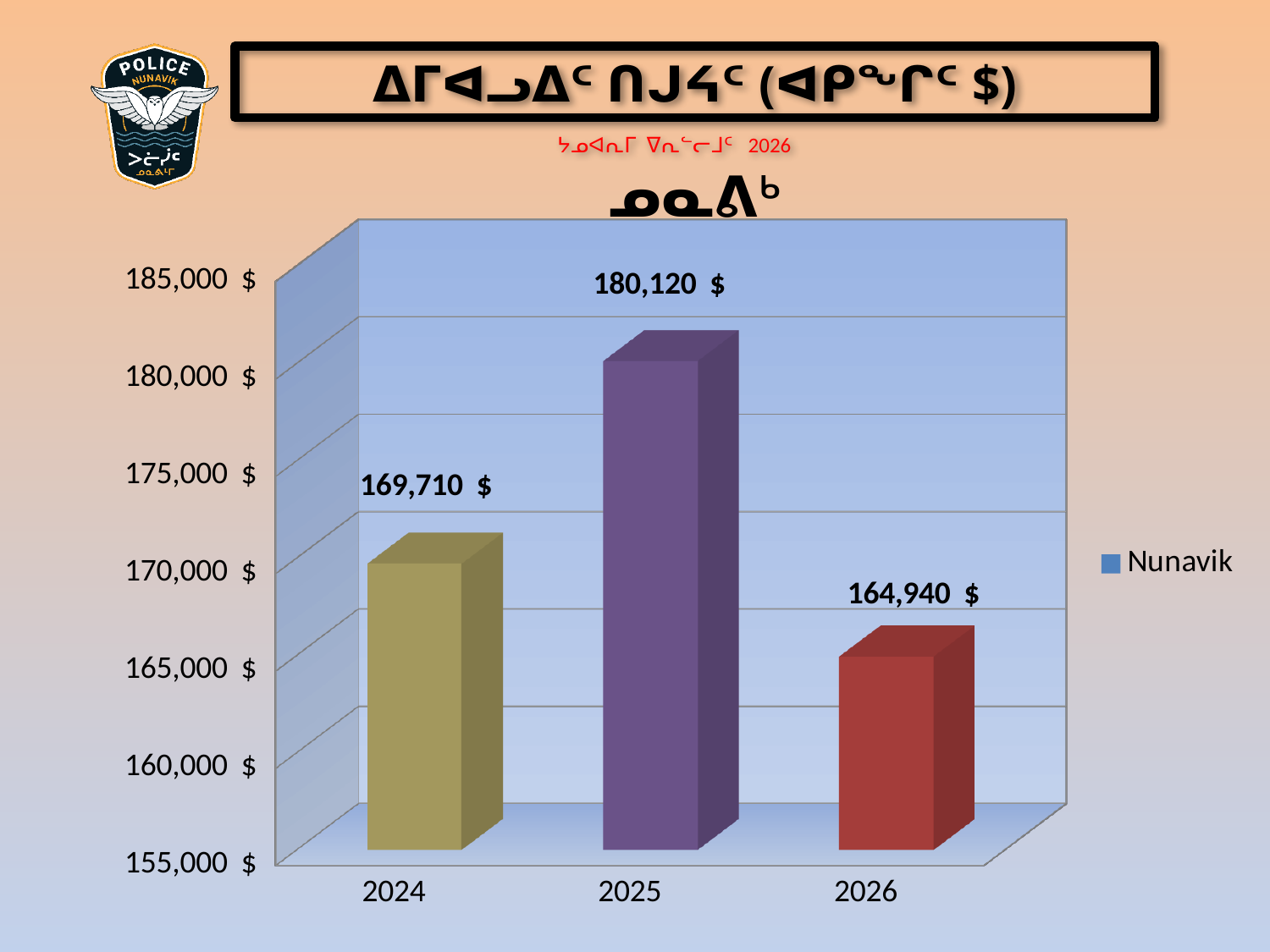
What is the value for 2024? 169,710 $ What is the value for 2025? 180,120 $ What is the value for 2026? 164,940 $ Which year has the highest value? 2025 Which year has the lowest value? 2026 How many years are shown on the x axis? 3 What is the difference between the values for 2025 and 2024? 10,410 $ What series name does the legend list? Nunavik What is the difference between the values for 2024 and 2026? 4,770 $ Is the value for 2025 greater or less than 175,000 $? greater What kind of chart is shown? bar chart Which is larger, the value for 2024 or the value for 2026? 2024